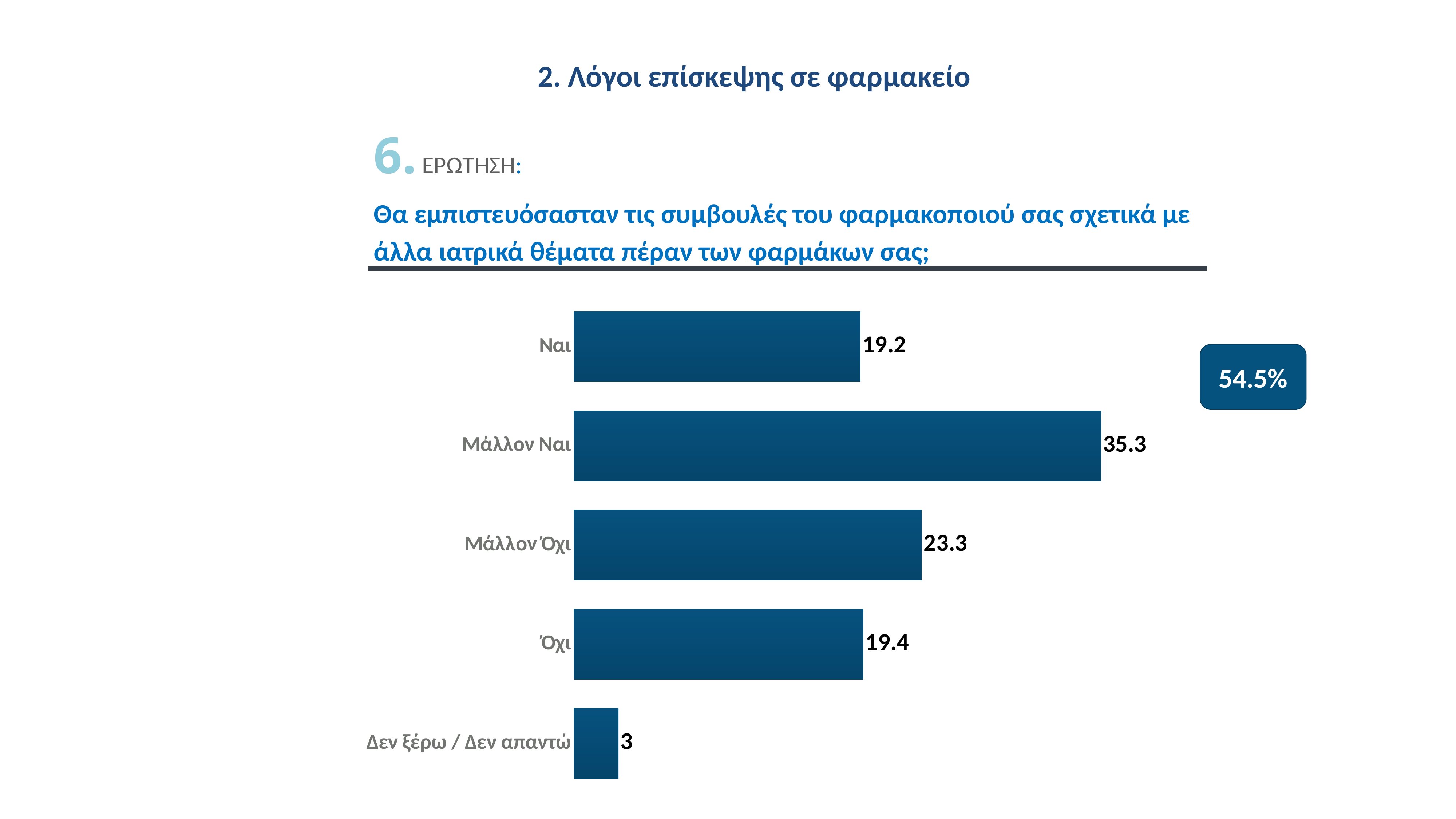
What kind of chart is shown on the slide? Bar chart How many categories are shown in the chart? 5 What is the value for Δεν ξέρω / Δεν απαντώ? 3 Which category has the highest value? Μάλλον Ναι What percentage is shown in the rounded box to the right of the chart? 54.5% Which category has the lowest value? Δεν ξέρω / Δεν απαντώ Which is larger, the value for Μάλλον Όχι or the value for Ναι? Μάλλον Όχι What is the value for Ναι? 19.2 What is the value for Μάλλον Ναι? 35.3 What is the difference between the values for Μάλλον Ναι and Μάλλον Όχι? 12 What is the value for Όχι? 19.4 What is the difference between the values for Όχι and Ναι? 0.2